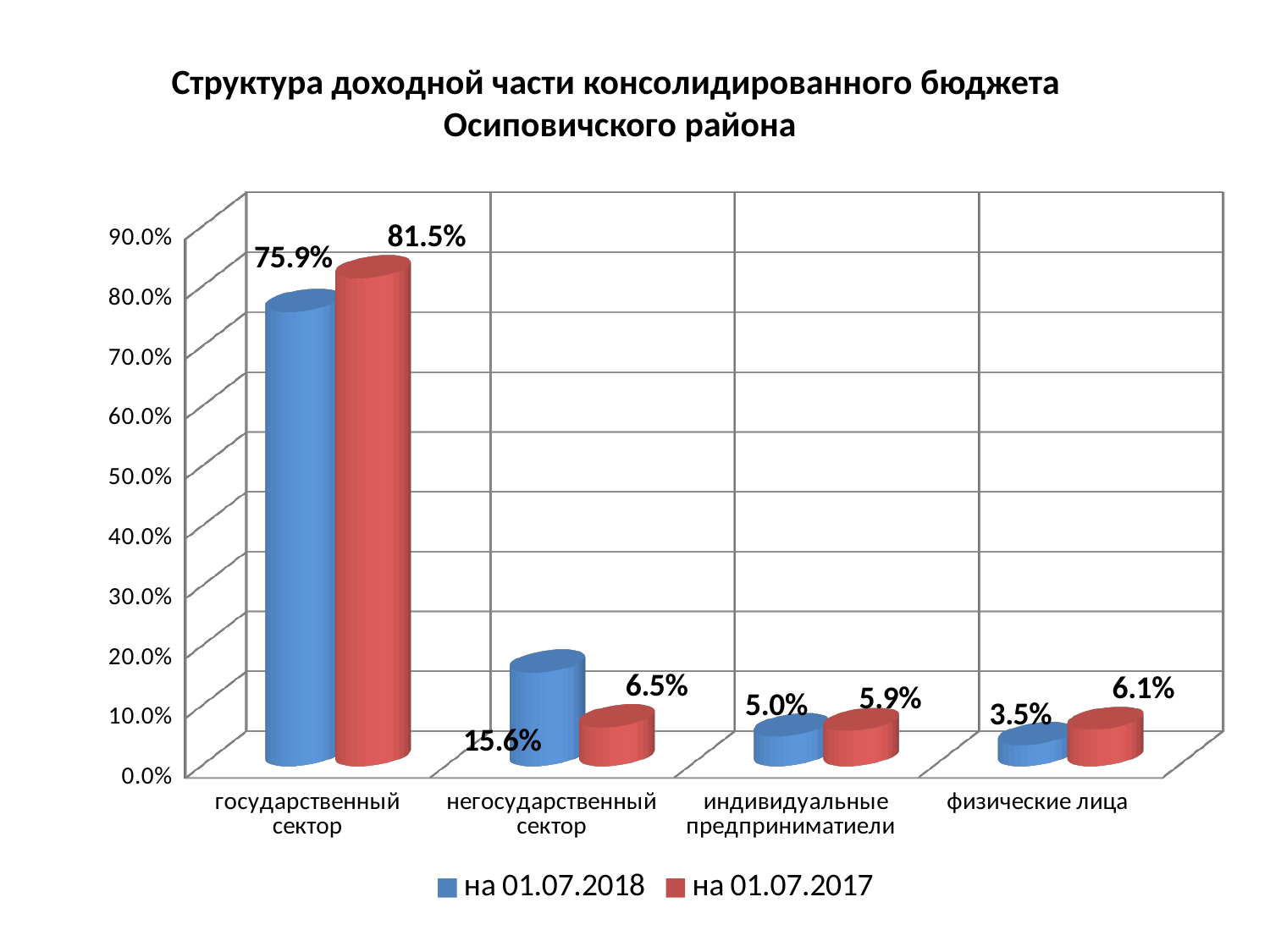
Which category has the lowest value in the series на 01.07.2018? физические лица Which category has the highest value in the series на 01.07.2018? государственный сектор What colour represents the series на 01.07.2017? red What kind of chart is shown on the slide? bar chart What is the difference between the на 01.07.2017 and на 01.07.2018 values for государственный сектор? 5.6% What is the value for государственный сектор in the series на 01.07.2017? 81.5% How many series does the legend list? 2 What is the value for государственный сектор in the series на 01.07.2018? 75.9% What is the value for физические лица in the series на 01.07.2017? 6.1% For негосударственный сектор, which series has the larger value: на 01.07.2018 or на 01.07.2017? на 01.07.2018 How many categories are shown on the x axis? 4 What is the value for негосударственный сектор in the series на 01.07.2018? 15.6%